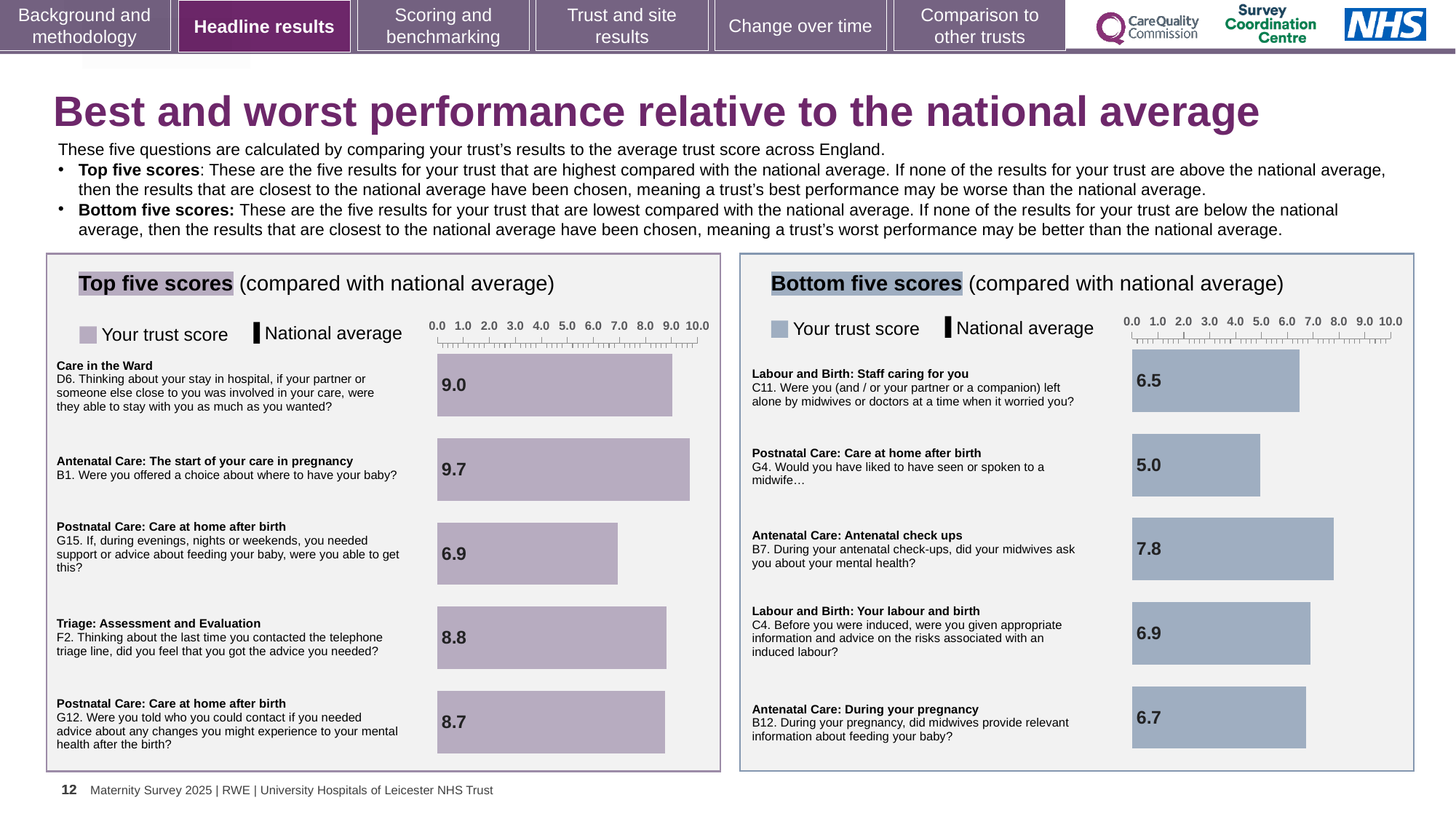
In the Bottom five scores chart, what is the trust score for question B7 about midwives asking about your mental health during antenatal check-ups? 7.8 In the Bottom five scores chart, which question has the lowest trust score? G4 In the Top five scores chart, what is the trust score for question B1 about being offered a choice about where to have your baby? 9.7 How many questions are shown in the Bottom five scores chart? 5 In the Top five scores chart, which question has the highest trust score? B1 In the Bottom five scores chart, is the trust score for C11 greater or less than 7.0? less What kind of chart is used in the Top five scores panel? Bar chart In the Top five scores chart, which has the larger trust score, F2 or G12? F2 In the Bottom five scores chart, what is the trust score for question G4 about whether you would have liked to have seen or spoken to a midwife? 5.0 In the Bottom five scores chart, what is the difference between the trust scores for B7 and G4? 2.8 In the Top five scores chart, what is the difference between the trust scores for B1 and G15? 2.8 In the Top five scores chart, what is the trust score for question G15 about support or advice about feeding your baby during evenings, nights or weekends? 6.9